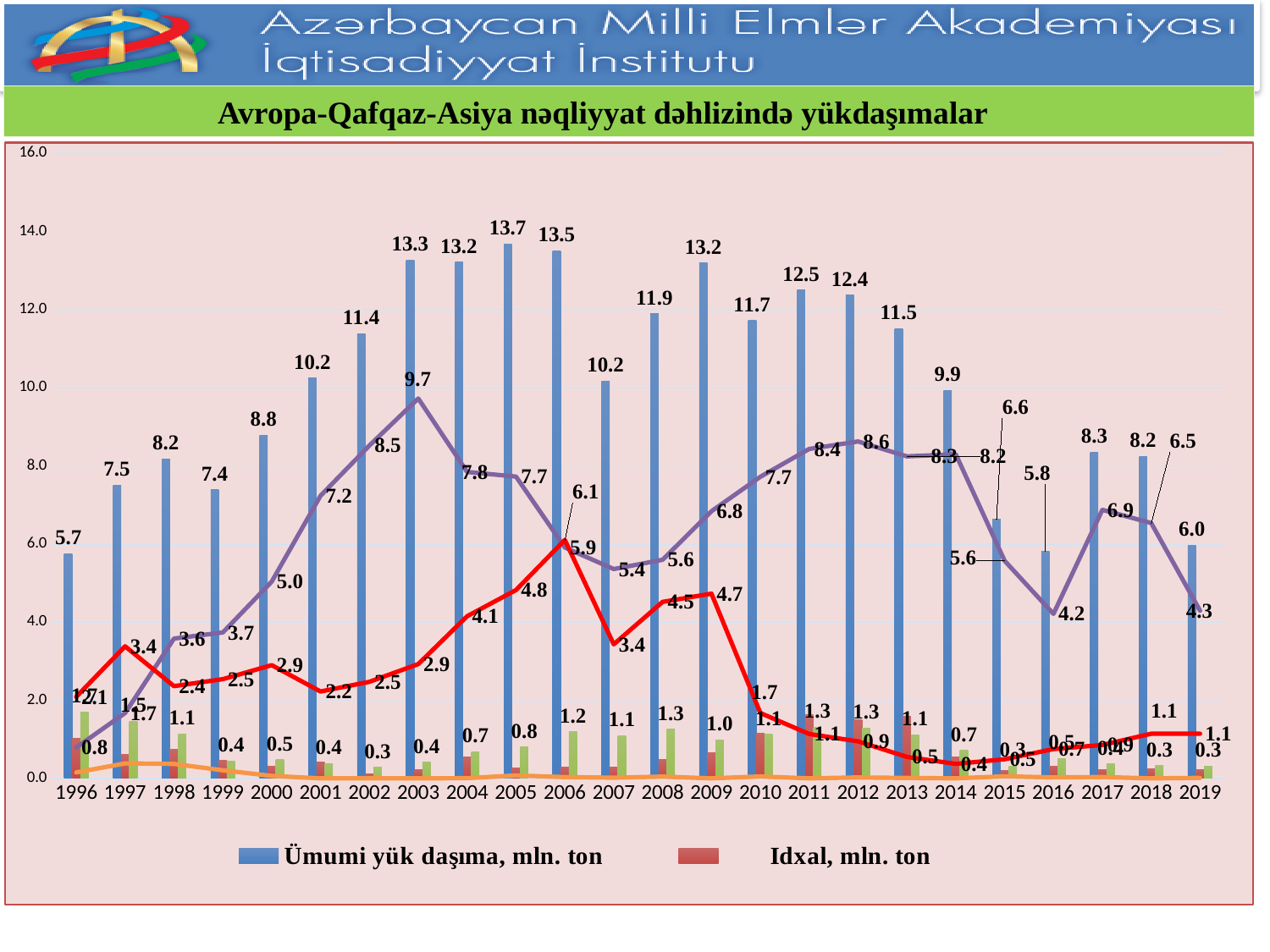
What is the difference between Ümumi yük daşıma, mln. ton in 2003 and in 2019? 7.3 What is the value of Ümumi yük daşıma, mln. ton for 2019? 6.0 What kind of chart is used for the Ümumi yük daşıma, mln. ton series? Bar chart Does Ümumi yük daşıma, mln. ton rise or fall from 2014 to 2016? Fall Which year has the larger value of Ümumi yük daşıma, mln. ton: 2010 or 2011? 2011 In which year is Ümumi yük daşıma, mln. ton the highest? 2005 How many series does the legend list? 2 In which year is Ümumi yük daşıma, mln. ton the lowest? 1996 What is the title of the chart? Avropa-Qafqaz-Asiya nəqliyyat dəhlizində yükdaşımalar Is the value of Ümumi yük daşıma, mln. ton for 2002 greater or less than 10.0? greater How many years are shown on the x axis of the chart? 24 What is the value of Ümumi yük daşıma, mln. ton for 2005? 13.7